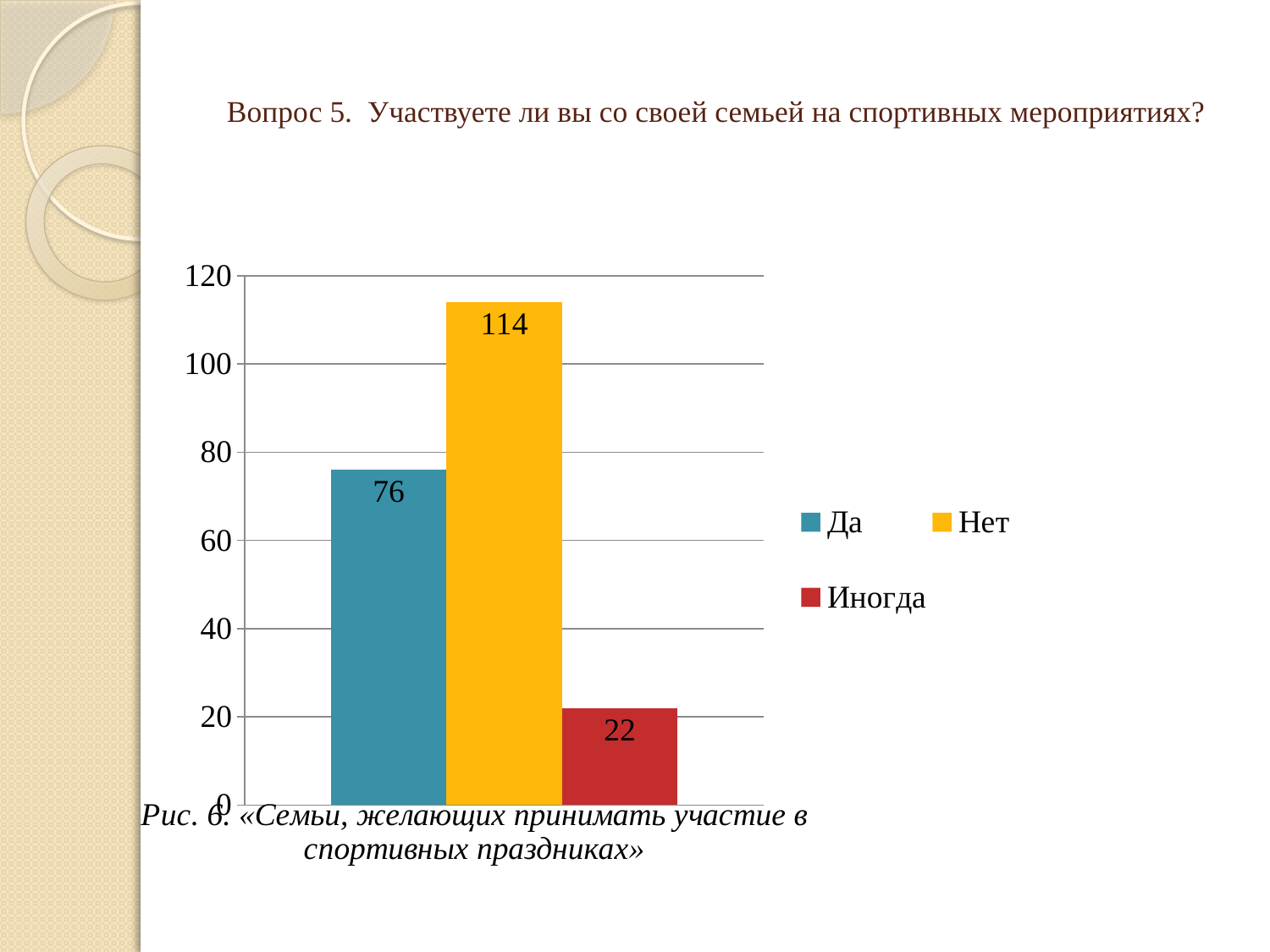
What colour is the bar for "Нет"? yellow Which category has the highest value? Нет How many series does the legend list? 3 What is the difference between the values for "Нет" and "Да"? 38 What is the value for "Да"? 76 What is the difference between the values for "Да" and "Иногда"? 54 What kind of chart is shown on the slide? bar chart Is the value for "Нет" greater or less than 100? greater What is the value for "Нет"? 114 Which is larger, the value for "Да" or the value for "Иногда"? Да What is the value for "Иногда"? 22 Which category has the lowest value? Иногда